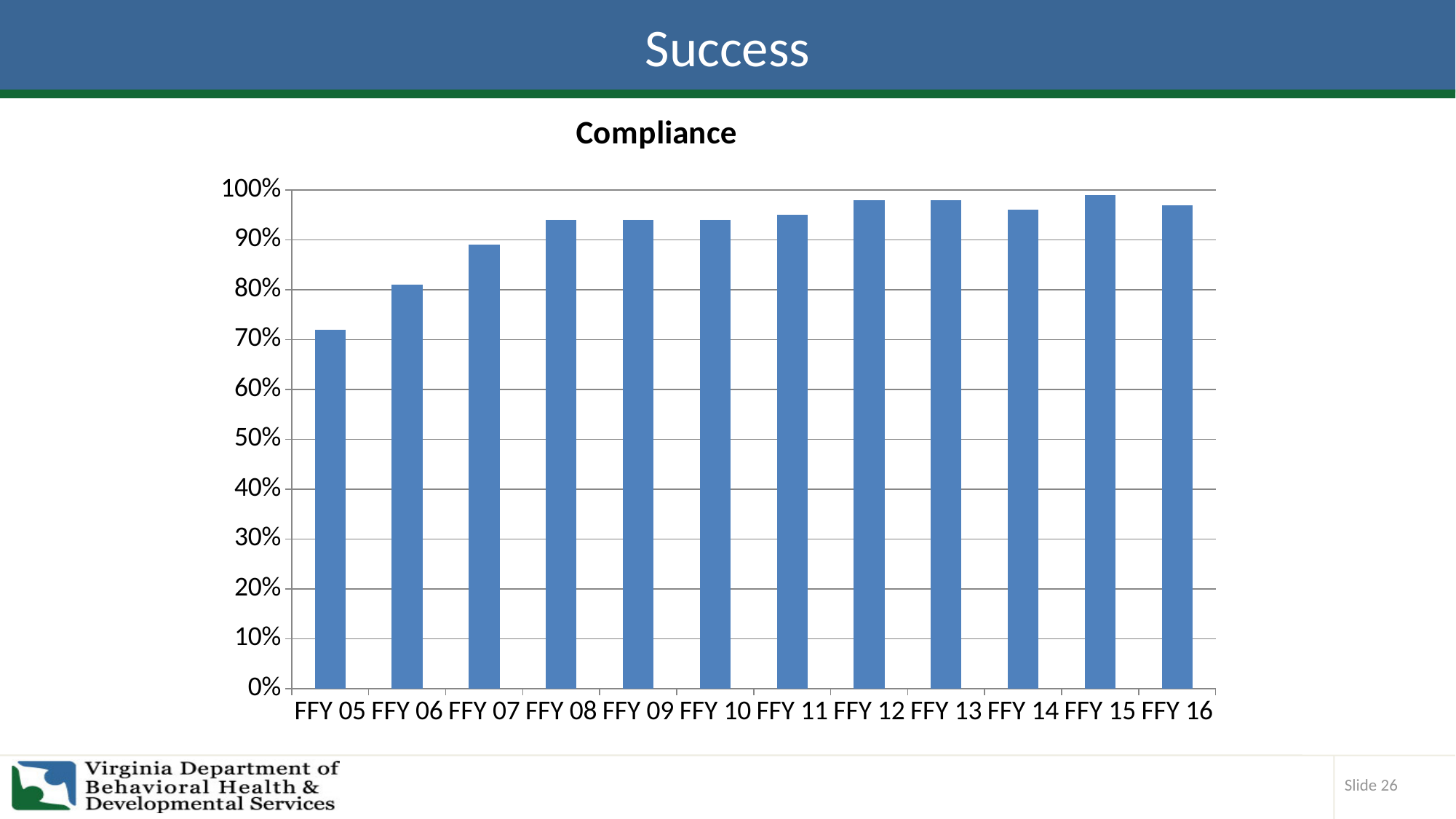
What is the title of the chart? Compliance Is the value for FFY 05 greater or less than 80%? less Is the value for FFY 12 greater or less than 90%? greater How many fiscal years (bars) are shown on the x axis? 12 Is the value for FFY 05 greater or less than 70%? greater Do the compliance values generally rise or fall from FFY 05 to FFY 08? rise Which fiscal year has the lowest compliance value? FFY 05 Which is larger, the value for FFY 07 or the value for FFY 15? FFY 15 What kind of chart is shown on the slide? bar chart Which is larger, the value for FFY 05 or the value for FFY 06? FFY 06